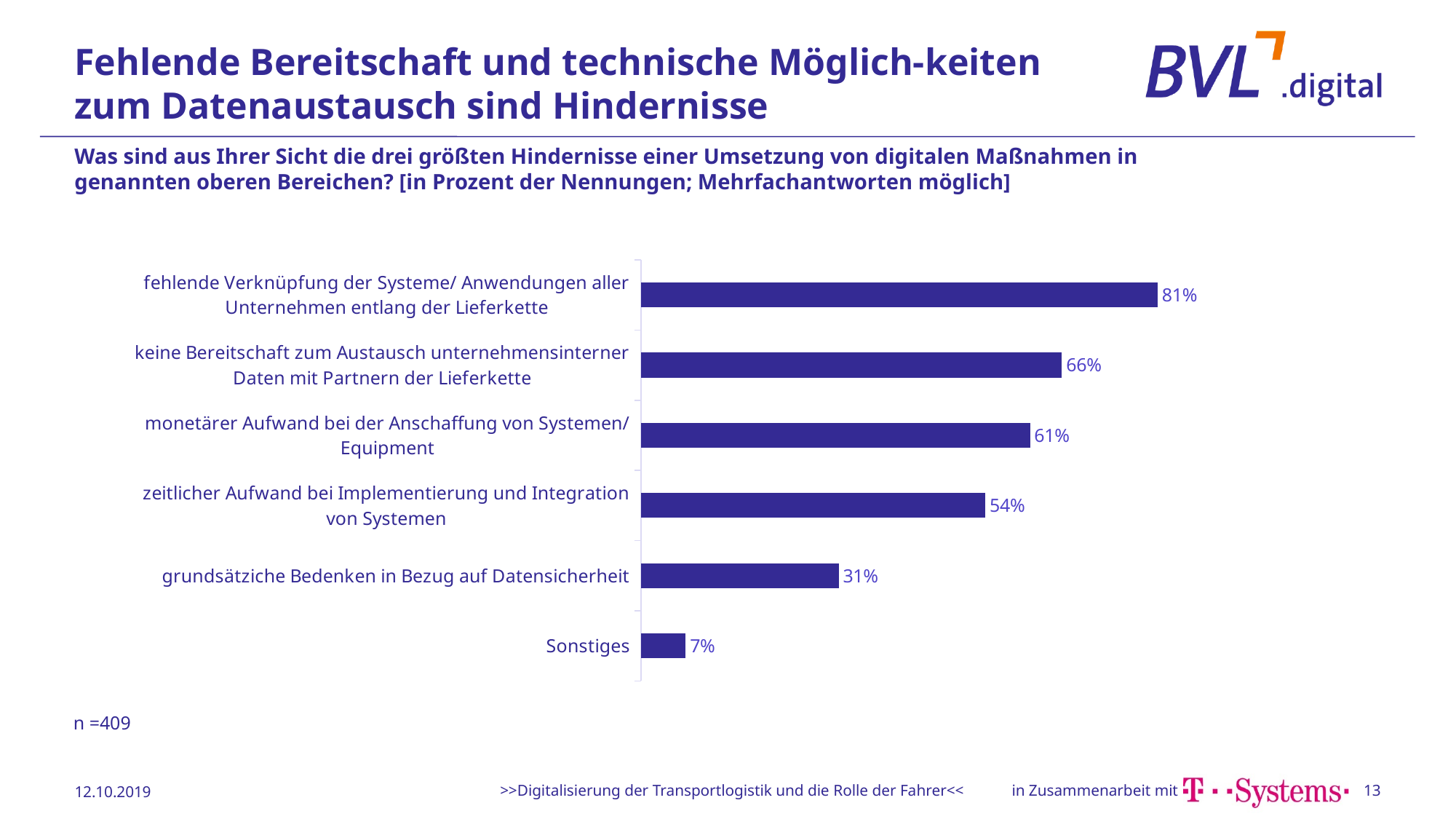
What is the value for "fehlende Verknüpfung der Systeme/ Anwendungen aller Unternehmen entlang der Lieferkette"? 81% What is the value for "keine Bereitschaft zum Austausch unternehmensinterner Daten mit Partnern der Lieferkette"? 66% Which is larger: the value for "monetärer Aufwand bei der Anschaffung von Systemen/ Equipment" or for "zeitlicher Aufwand bei Implementierung und Integration von Systemen"? monetärer Aufwand bei der Anschaffung von Systemen/ Equipment Which category has the lowest value? Sonstiges What is the sample size (n) stated below the chart? 409 What is the difference between the highest and lowest values in the chart? 74% Which category has the highest value? fehlende Verknüpfung der Systeme/ Anwendungen aller Unternehmen entlang der Lieferkette What kind of chart is shown on the slide? bar chart What is the value for "grundsätziche Bedenken in Bezug auf Datensicherheit"? 31% What is the value for "monetärer Aufwand bei der Anschaffung von Systemen/ Equipment"? 61% What is the difference between the values for "keine Bereitschaft zum Austausch unternehmensinterner Daten mit Partnern der Lieferkette" and "zeitlicher Aufwand bei Implementierung und Integration von Systemen"? 12% How many categories are shown in the chart? 6